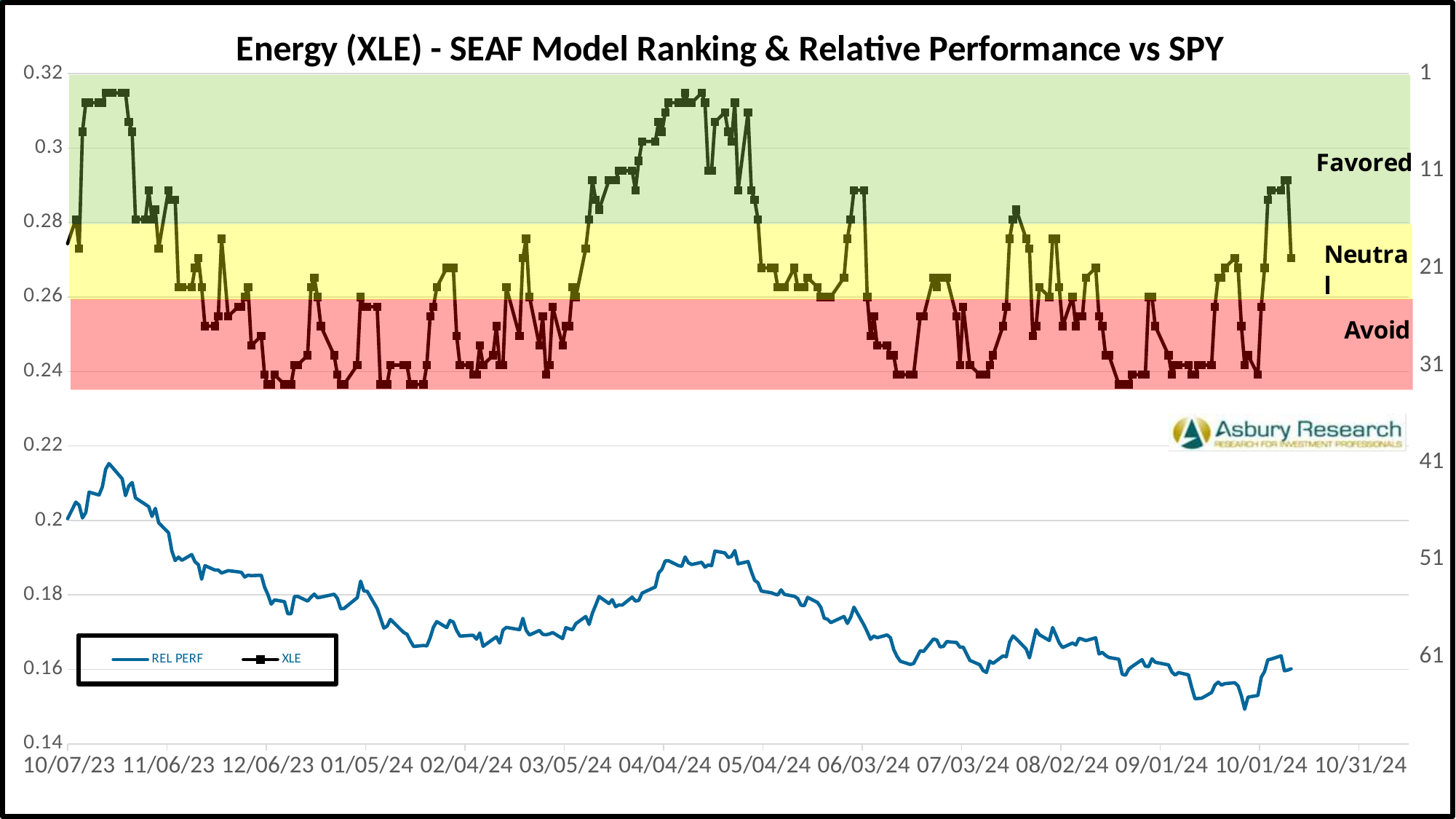
Is the REL PERF value at 10/07/23 greater or less than 0.18? greater Is the REL PERF value at 10/01/24 greater or less than 0.18? less How many series does the legend list? 2 Which is larger, the REL PERF value at 10/07/23 or at 10/01/24? 10/07/23 How many date labels are shown on the x axis? 14 Is the XLE ranking around 04/04/24 greater or less than 11 on the right axis? less What is the title of the chart? Energy (XLE) - SEAF Model Ranking & Relative Performance vs SPY What kind of chart is shown on the slide? line chart Overall, does the REL PERF line rise or fall from 10/07/23 to 10/01/24? fall What are the three zone labels shown on the right side of the shaded bands? Favored, Neutral, Avoid